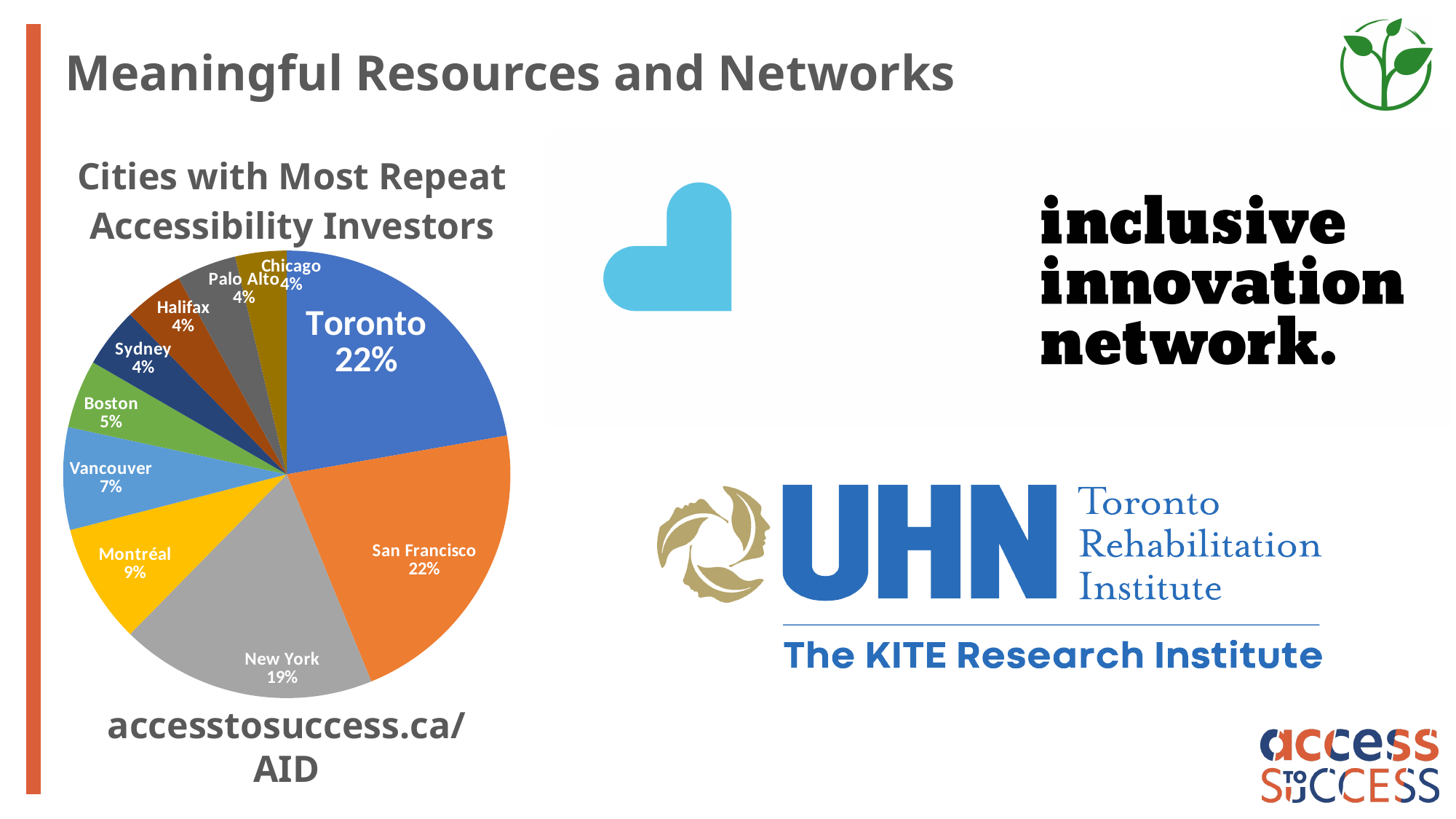
What type of chart is used to show the cities with most repeat accessibility investors? Pie chart What is the title of the pie chart on the slide? Cities with Most Repeat Accessibility Investors What share of the pie does Toronto hold in the 'Cities with Most Repeat Accessibility Investors' chart? 22% What is the value shown for San Francisco in the pie chart? 22% What is the value shown for New York in the pie chart? 19% What is the value shown for Vancouver in the pie chart? 7% Which has a larger share in the pie chart, Vancouver or Boston? Vancouver What percentage is shown for Montréal in the pie chart? 9% What percentage does Boston account for in the pie chart? 5% What is the difference in percentage points between Toronto and New York in the pie chart? 3% How many cities (slices) are shown in the pie chart? 10 Which has a larger share in the pie chart, New York or Montréal? New York